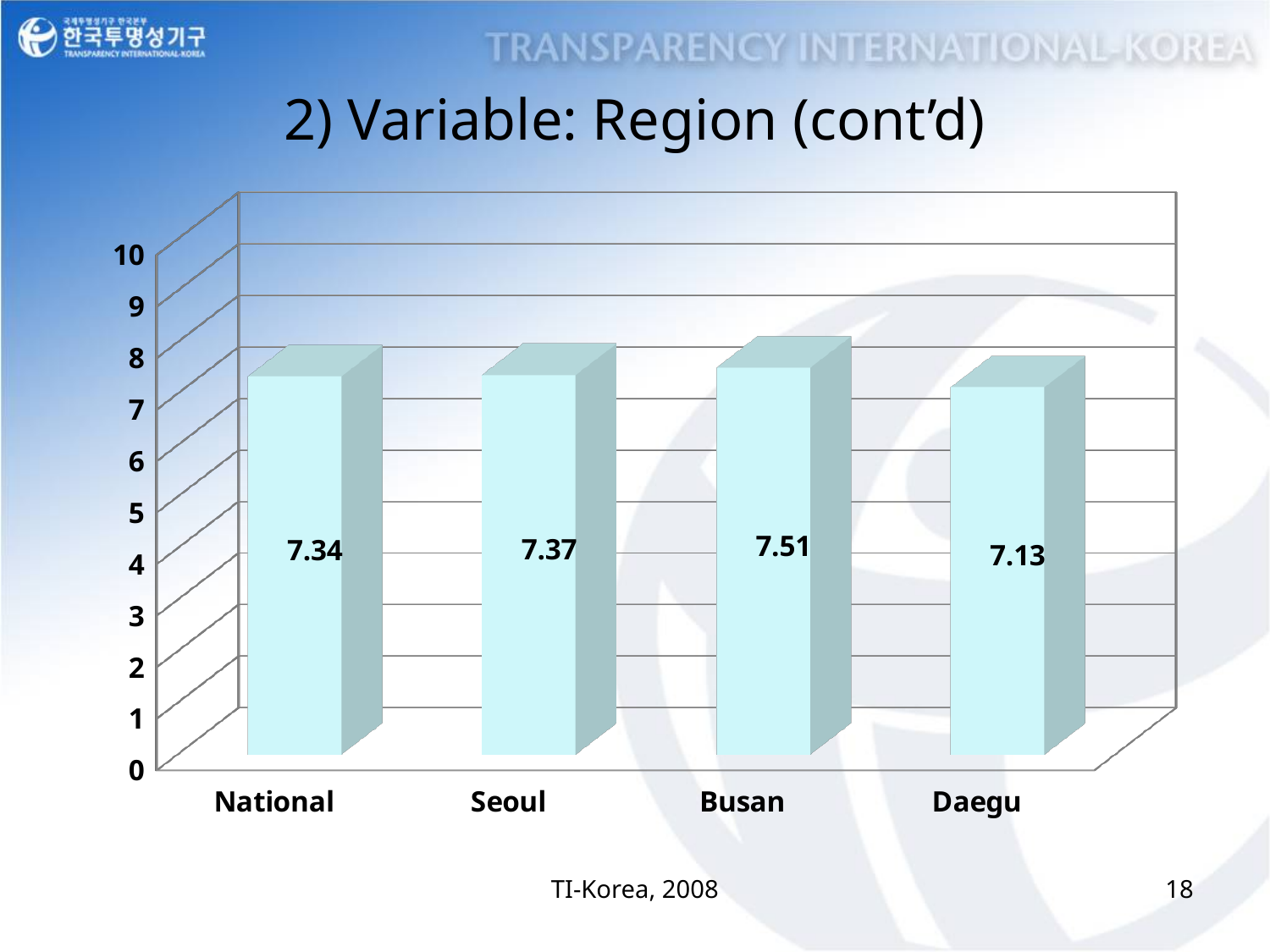
What is the value for National? 7.34 What is the difference between the values for Seoul and National? 0.03 Which category has the lowest value? Daegu Which is larger, the value for Busan or the value for Daegu? Busan What is the difference between the values for Busan and Daegu? 0.38 Is the value for Daegu greater or less than 8? less What is the value for Daegu? 7.13 What is the value for Busan? 7.51 What is the value for Seoul? 7.37 How many categories are shown on the x axis? 4 What kind of chart is shown on the slide? bar chart Which category has the highest value? Busan